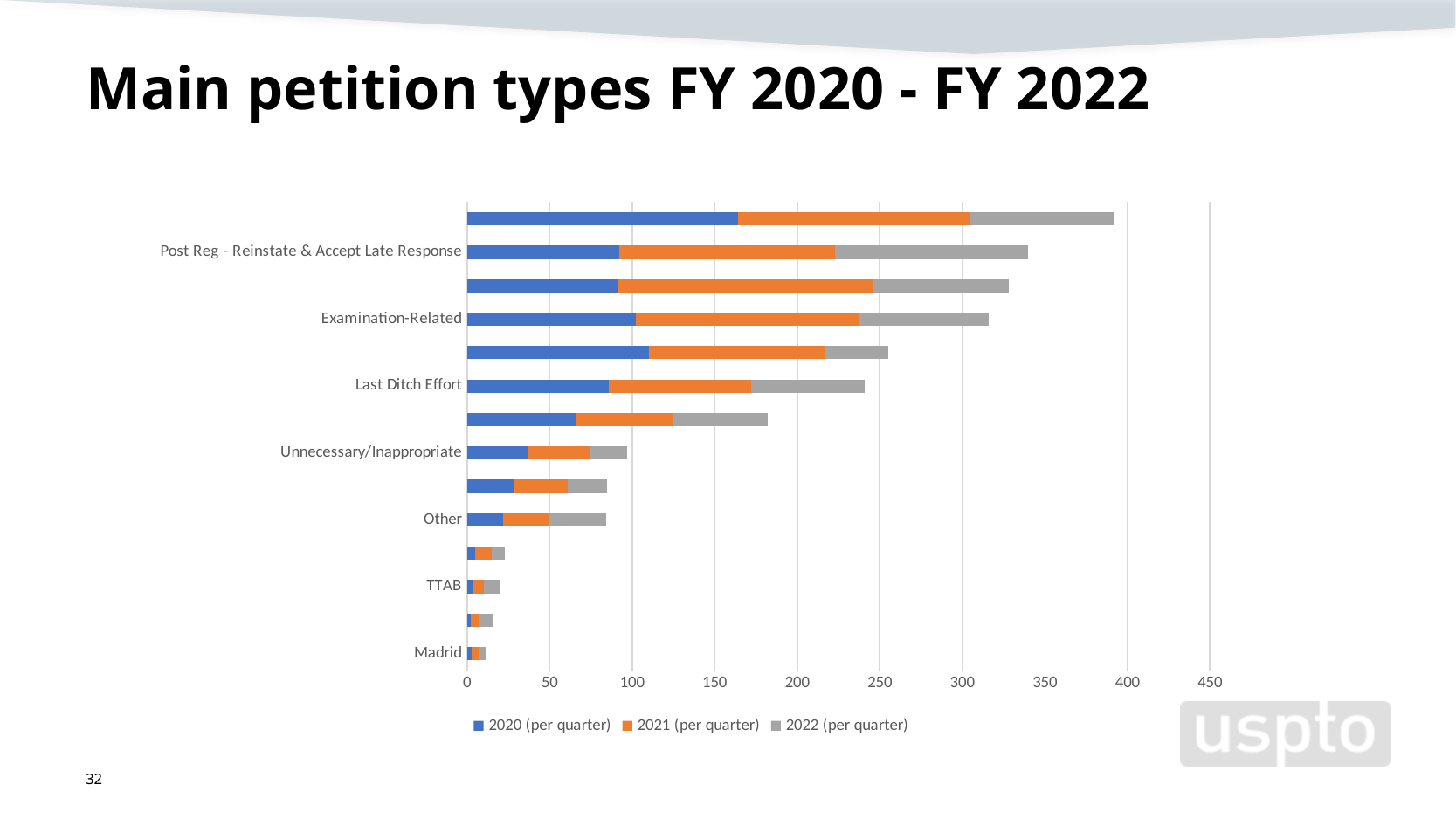
What is the title of the slide containing the chart? Main petition types FY 2020 - FY 2022 Which series are listed in the legend? 2020 (per quarter), 2021 (per quarter), 2022 (per quarter) Is the total bar length for Post Reg - Reinstate & Accept Late Response greater or less than 300? greater Is the total bar length for Other greater or less than 100? less What type of chart is shown on the slide? Stacked bar chart Is the total bar length for Madrid greater or less than 50? less Among the labeled petition types, which has the shortest total bar? Madrid Do the total bar lengths generally increase or decrease moving from the top of the chart to the bottom? decrease Which has the longer total bar, Post Reg - Reinstate & Accept Late Response or Last Ditch Effort? Post Reg - Reinstate & Accept Late Response How many series does the legend list? 3